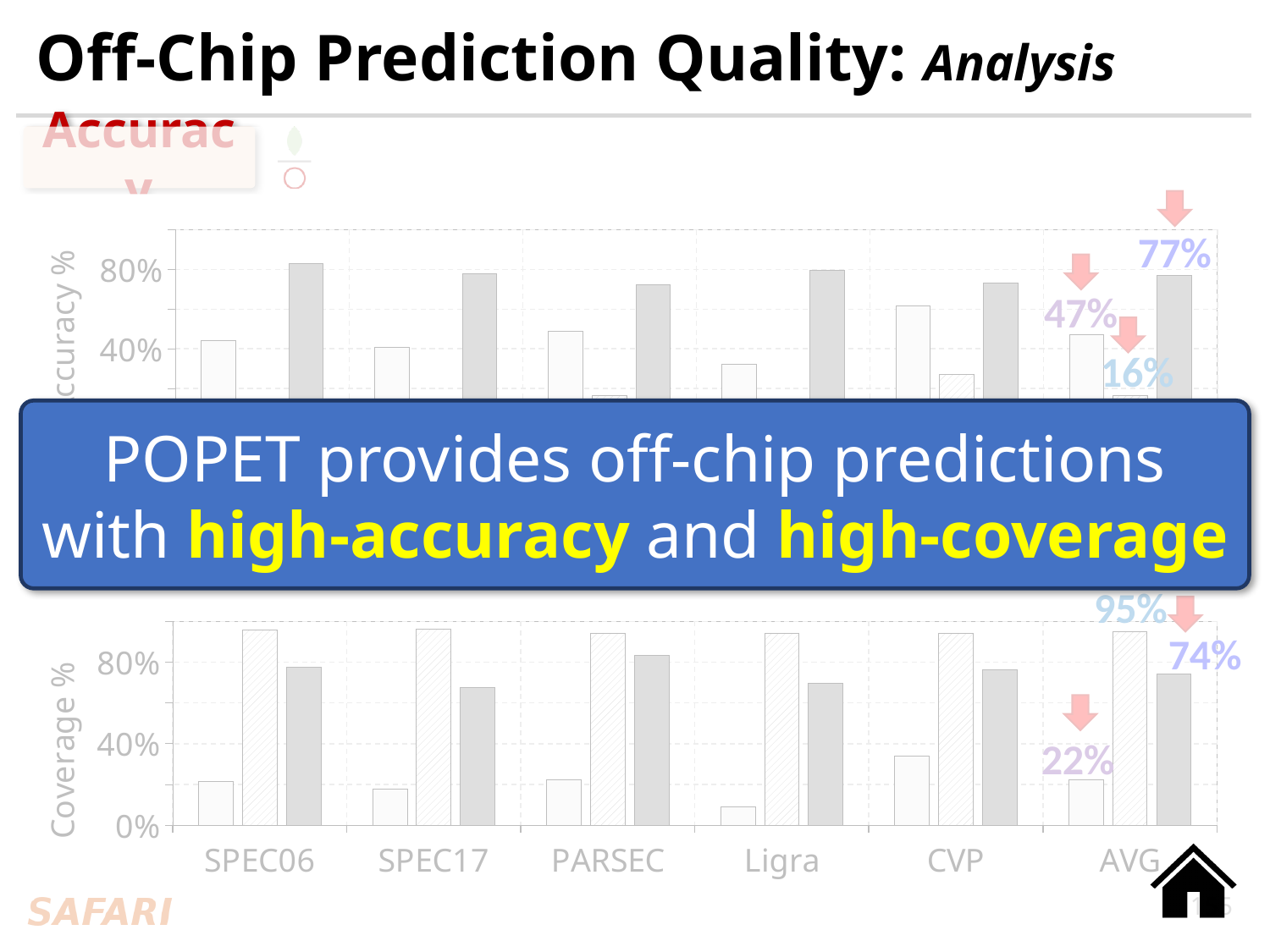
What is the y-axis label of the bottom chart? Coverage % In the Coverage % chart, what is the highest value labelled for AVG? 95% In the Coverage % chart, is the value of the first (white) bar for Ligra greater or less than 40%? less In the Coverage % chart, is the value of the grey bar for SPEC06 greater or less than 40%? greater In the Coverage % chart, what is the lowest value labelled for AVG? 22% In the Accuracy % chart, what is the difference between the 77% and 47% AVG values? 30 percentage points What kind of chart is the Coverage % chart at the bottom of the slide? bar chart In the Accuracy % chart, what is the highest value labelled for AVG? 77% In the Coverage % chart, what is the difference between the 95% and 74% AVG values? 21 percentage points In the Accuracy % chart, what is the lowest value labelled for AVG? 16% In the Coverage % chart, what is the value labelled on the grey AVG bar? 74% How many categories are shown along the x axis of the Coverage % chart? 6